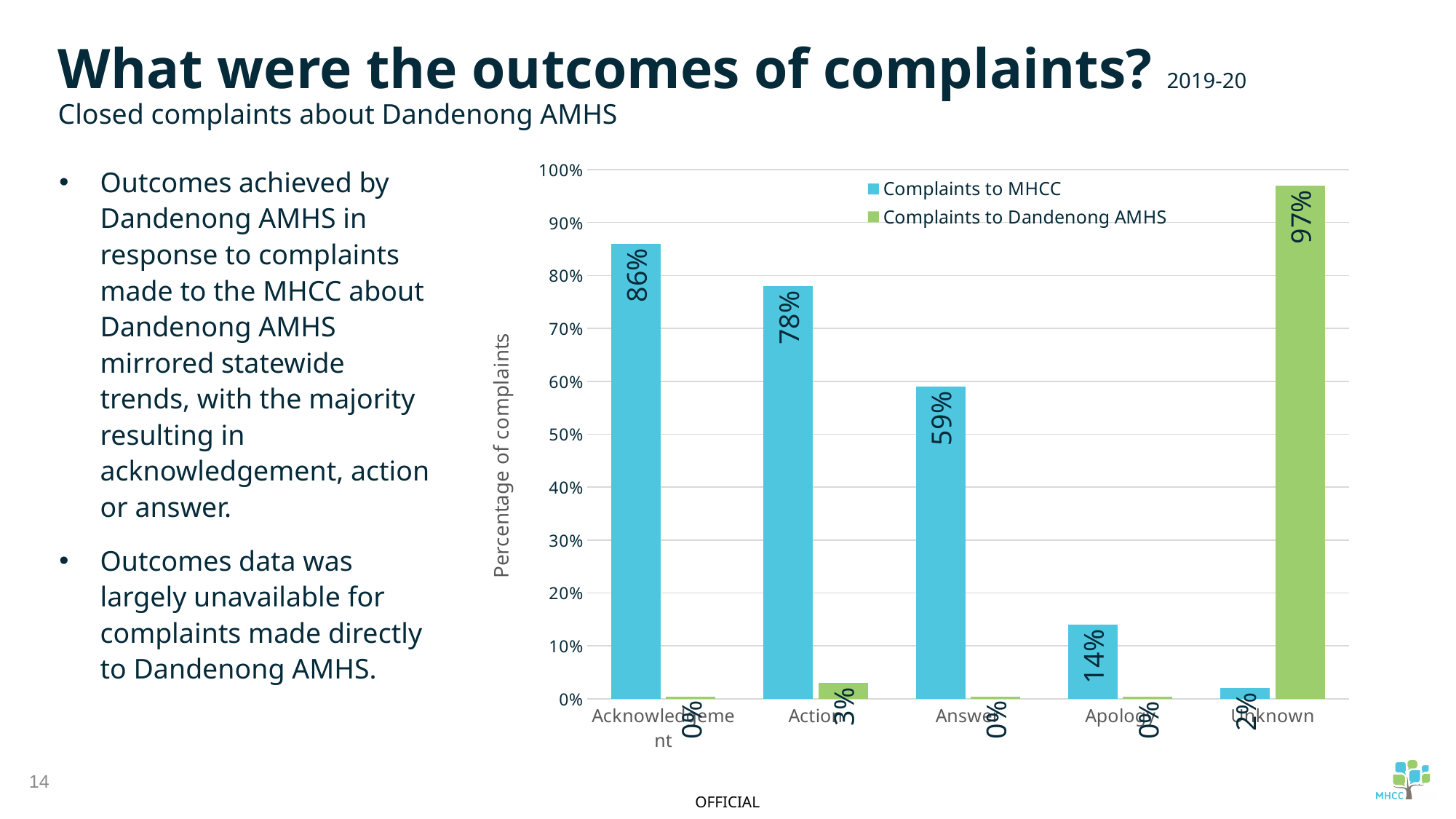
What percentage of complaints to MHCC resulted in Acknowledgement? 86% How many outcome categories are shown on the x axis? 5 What percentage of complaints to MHCC resulted in Apology? 14% What is the label of the vertical axis? Percentage of complaints What percentage of complaints to Dandenong AMHS had an Unknown outcome? 97% For the Answer category, which series has the larger value: Complaints to MHCC or Complaints to Dandenong AMHS? Complaints to MHCC How many series does the legend list? 2 What percentage of complaints to Dandenong AMHS resulted in Action? 3% Which outcome category has the lowest value for Complaints to MHCC? Unknown What kind of chart is shown on the slide? Bar chart What is the difference between the Complaints to MHCC values for Acknowledgement and Action? 8% Which outcome category has the highest value for Complaints to MHCC? Acknowledgement